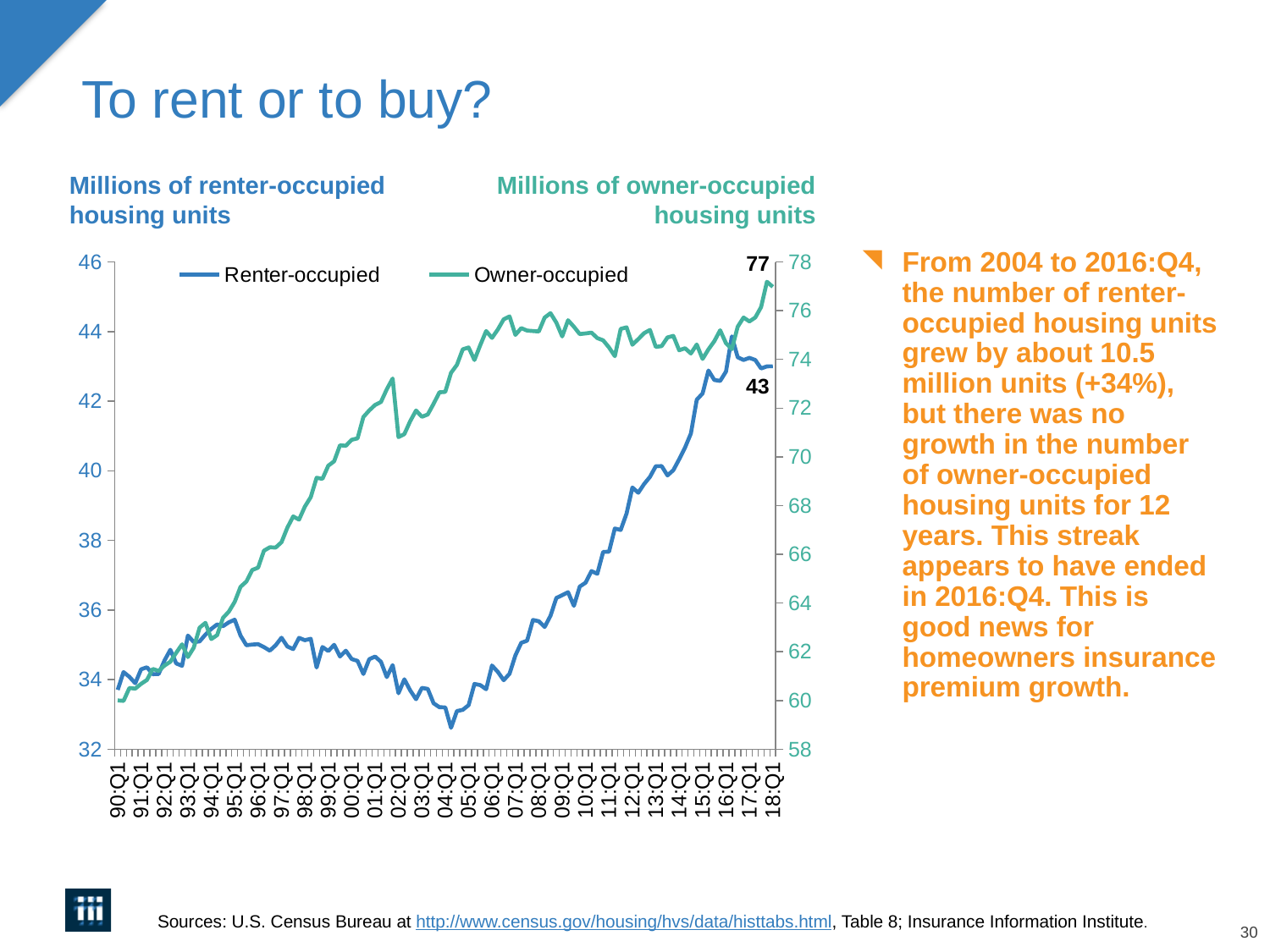
Is the value for Owner-occupied at 95:Q1 greater or less than 66? less What are the two entries in the chart's legend? Renter-occupied and Owner-occupied What is the labelled value of the Owner-occupied series at the end of the chart (18:Q1)? 77 Does the Owner-occupied series rise or fall between 90:Q1 and 06:Q1? rise How many series does the chart's legend list? 2 What is the title of the left-hand axis of the chart? Millions of renter-occupied housing units Which series has the higher labelled value at the end of the chart, Renter-occupied or Owner-occupied? Owner-occupied What is the labelled value of the Renter-occupied series at the end of the chart (18:Q1)? 43 Is the value for Renter-occupied at 04:Q1 greater or less than 34? less What kind of chart is shown on the slide? line chart Does the Renter-occupied series rise or fall between 04:Q1 and 16:Q1? rise What is the difference, in millions of units, between the labelled end values of the Owner-occupied (77) and Renter-occupied (43) series? 34